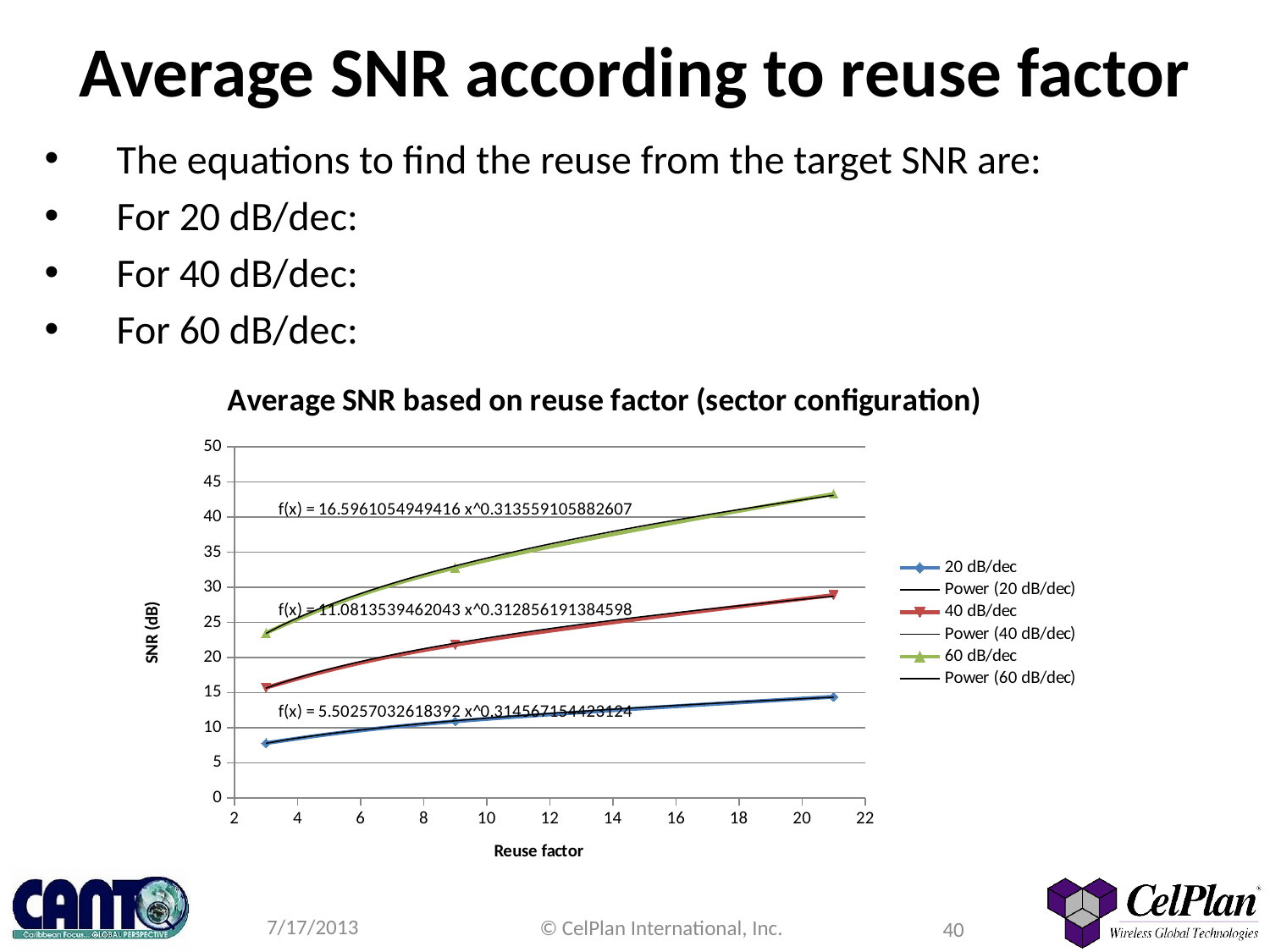
Does the SNR for the 40 dB/dec series rise or fall as the reuse factor increases? rise What is the label of the y axis of the chart? SNR (dB) What type of chart is shown on the slide? line chart Is the SNR for the 60 dB/dec series at reuse factor 21 greater or less than 40? greater How many entries does the chart legend list? 6 Which series has the highest SNR values across the reuse factors? 60 dB/dec Is the SNR for the 20 dB/dec series at reuse factor 3 greater or less than 10? less Is the SNR for the 40 dB/dec series at reuse factor 9 greater or less than 20? greater What is the title of the chart? Average SNR based on reuse factor (sector configuration) How many data points are plotted for the 60 dB/dec series? 3 At reuse factor 9, which series has the larger SNR, 60 dB/dec or 20 dB/dec? 60 dB/dec Which series has the lowest SNR values across the reuse factors? 20 dB/dec